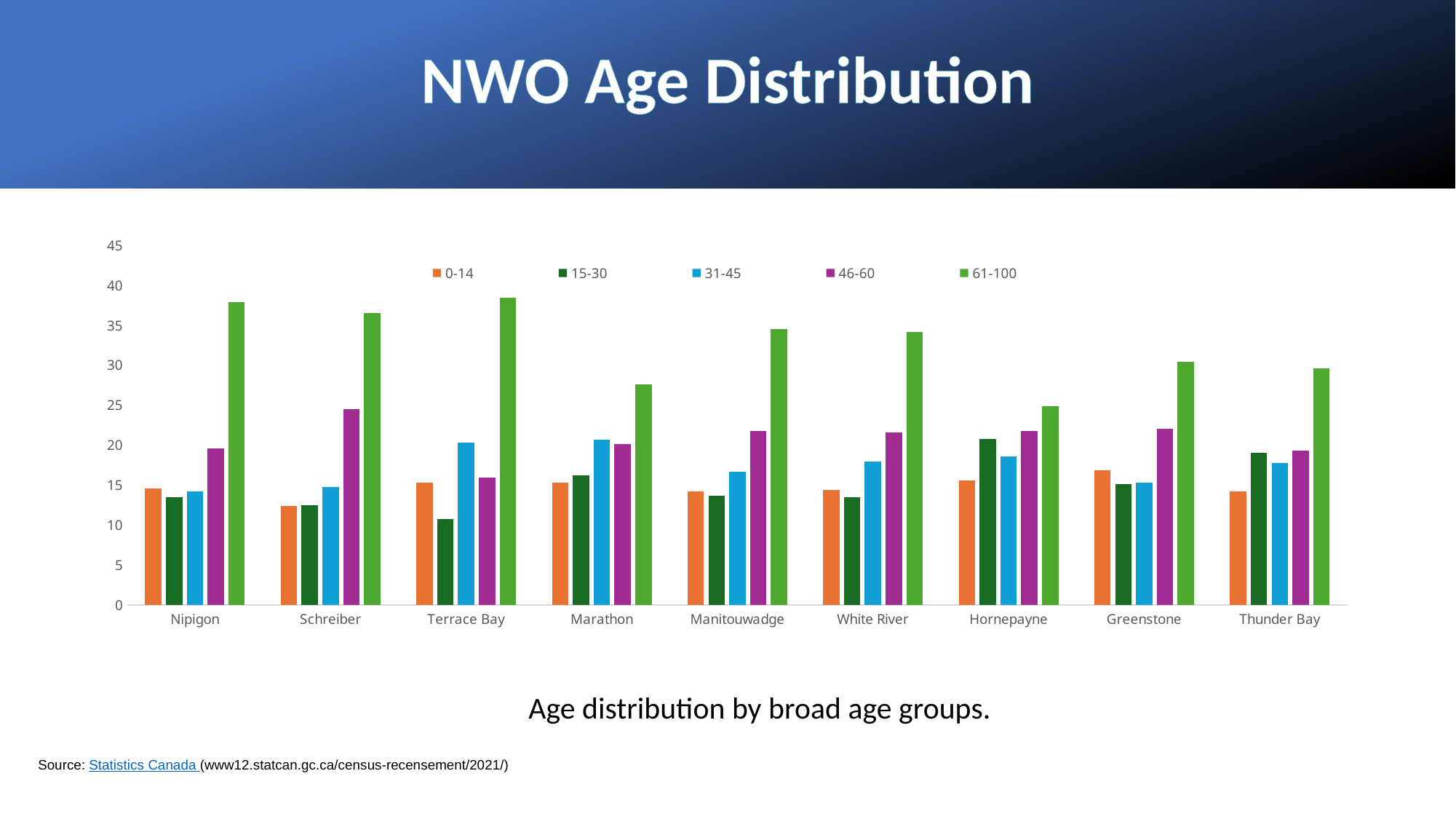
Is the value for the 61-100 age group in Marathon greater or less than 25? greater Which community has the highest value for the 46-60 age group? Schreiber Is the value for the 15-30 age group in Terrace Bay greater or less than 15? less What kind of chart is shown on the slide? bar chart Which community has the lowest value for the 15-30 age group? Terrace Bay Which community has the highest value for the 15-30 age group? Hornepayne How many age groups does the legend list? 5 Which community has the lowest value for the 61-100 age group? Hornepayne In Terrace Bay, which is larger: the 31-45 age group or the 46-60 age group? 31-45 Is the value for the 61-100 age group in Nipigon greater or less than 35? greater How many communities are shown on the x axis of the chart? 9